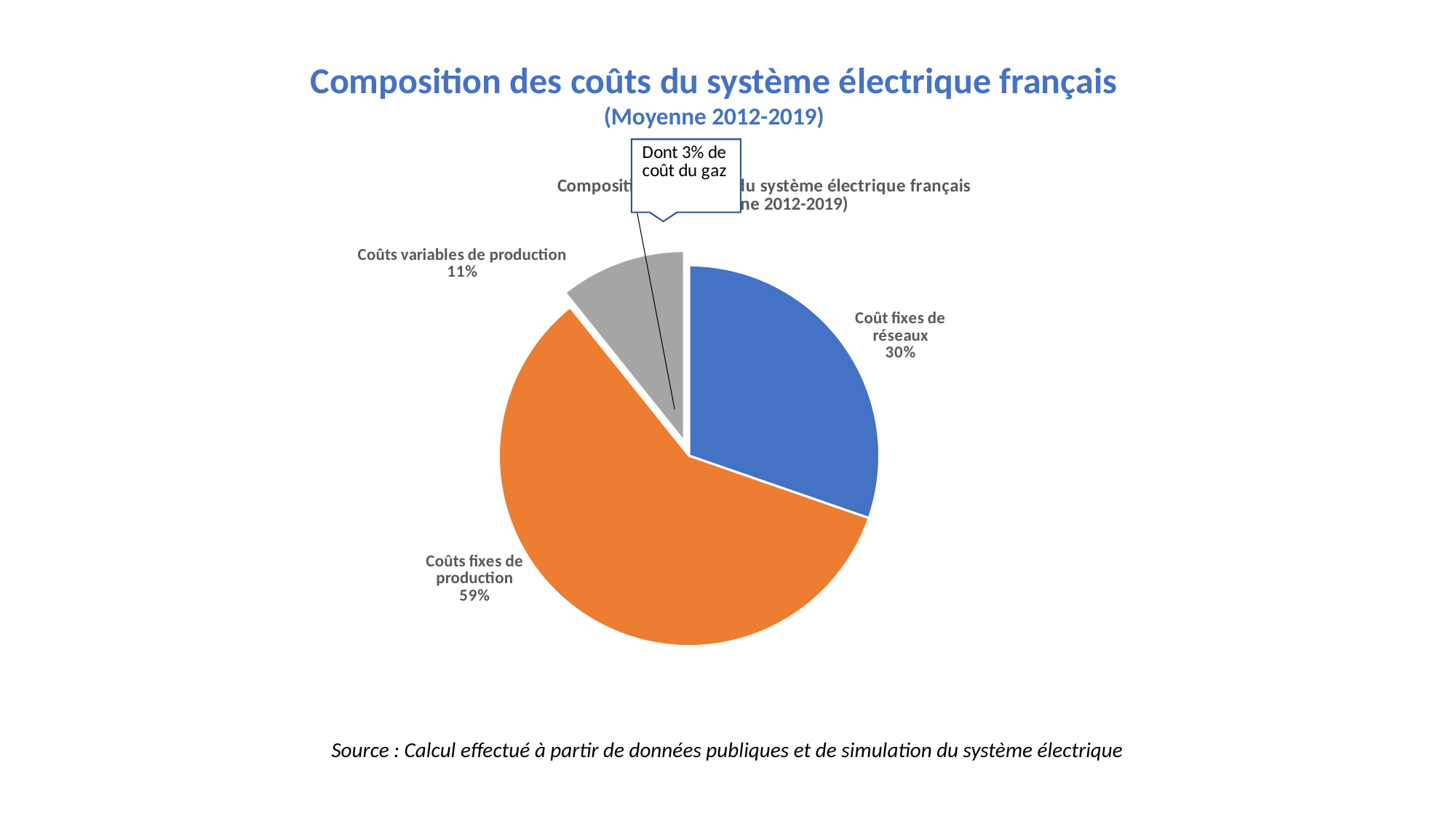
According to the callout, what share of the costs is attributed to the cost of gas? 3% What share of the pie is 'Coûts fixes de production'? 59% What colour is the slice for 'Coûts fixes de production'? Orange Which is larger, 'Coût fixes de réseaux' or 'Coûts variables de production'? Coût fixes de réseaux What share of the pie is 'Coûts variables de production'? 11% What share of the pie is 'Coût fixes de réseaux'? 30% What is the difference in percentage points between 'Coûts fixes de production' and 'Coût fixes de réseaux'? 29 How many slices does the pie chart have? 3 Which category has the smallest slice of the pie? Coûts variables de production What kind of chart is shown on the slide? Pie chart What is the difference in percentage points between 'Coût fixes de réseaux' and 'Coûts variables de production'? 19 Which category has the largest slice of the pie? Coûts fixes de production